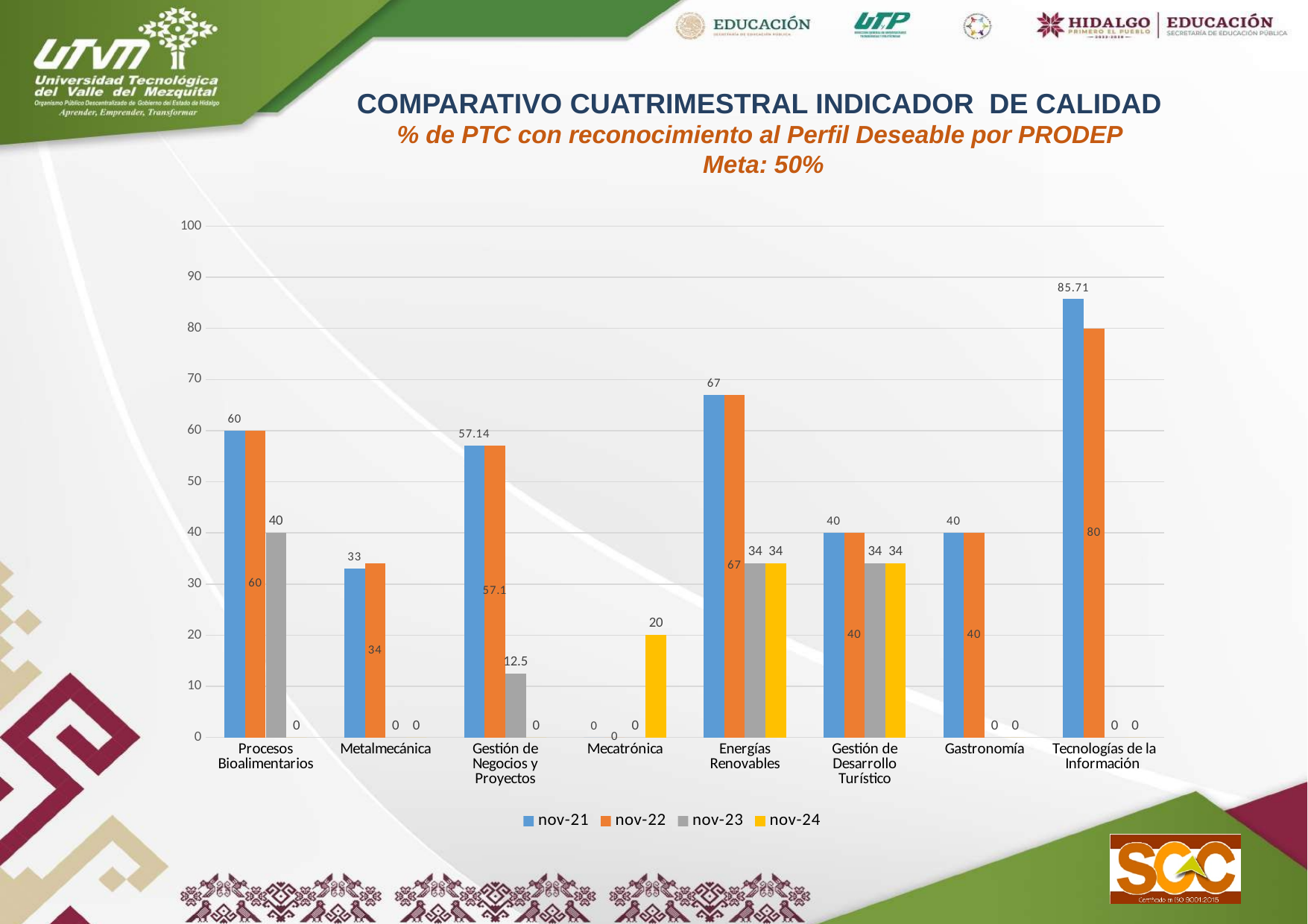
What is the nov-21 value for Tecnologías de la Información? 85.71 Which is larger: the nov-21 value for Energías Renovables or the nov-21 value for Gestión de Desarrollo Turístico? Energías Renovables How many categories (programs) are shown along the x axis? 8 What is the nov-22 value for Metalmecánica? 34 What is the nov-24 value for Mecatrónica? 20 What kind of chart is shown on the slide? bar chart Which category has the highest nov-21 value? Tecnologías de la Información What is the difference between the nov-22 and nov-23 values for Procesos Bioalimentarios? 20 What target (Meta) is stated in the chart's subtitle? 50% How many series does the legend list? 4 What is the nov-23 value for Gestión de Negocios y Proyectos? 12.5 What is the difference between the nov-21 and nov-22 values for Tecnologías de la Información? 5.71